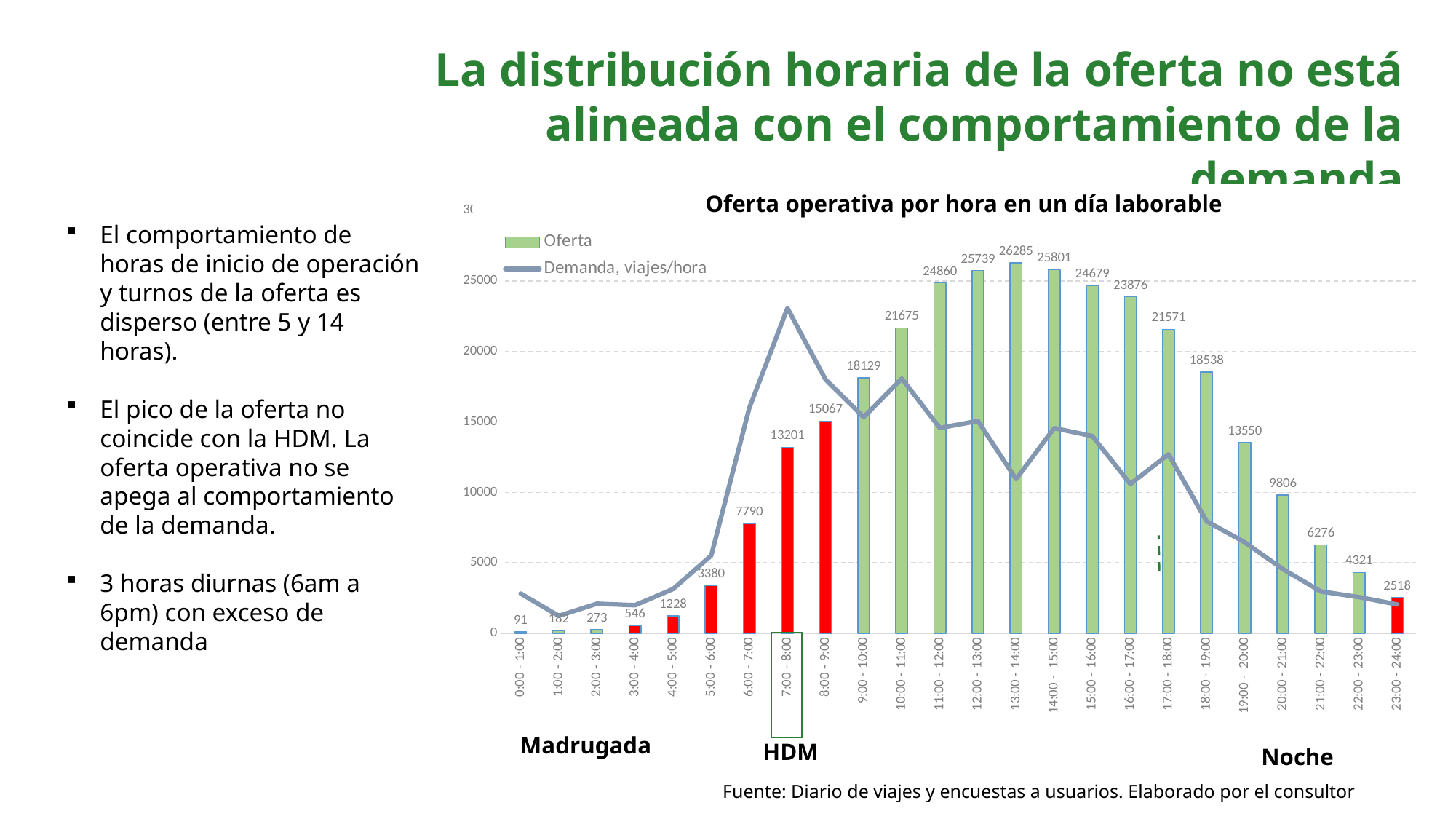
Which hour has the highest Oferta value? 13:00 - 14:00 What is the Oferta value for the 7:00 - 8:00 hour? 13201 Which is larger, the Oferta value for 10:00 - 11:00 or for 17:00 - 18:00? 10:00 - 11:00 Is the Demanda, viajes/hora value for 13:00 - 14:00 greater or less than 15000? less Is the Demanda, viajes/hora value for 7:00 - 8:00 greater or less than 20000? greater How many hourly categories are shown on the x axis? 24 What is the Oferta value for the 23:00 - 24:00 hour? 2518 How many series does the legend list? 2 What kind of chart is shown on the slide? Combined bar and line chart Which hour has the lowest Oferta value? 0:00 - 1:00 What is the difference between the Oferta values for 8:00 - 9:00 and 7:00 - 8:00? 1866 What is the Oferta value for the 13:00 - 14:00 hour? 26285